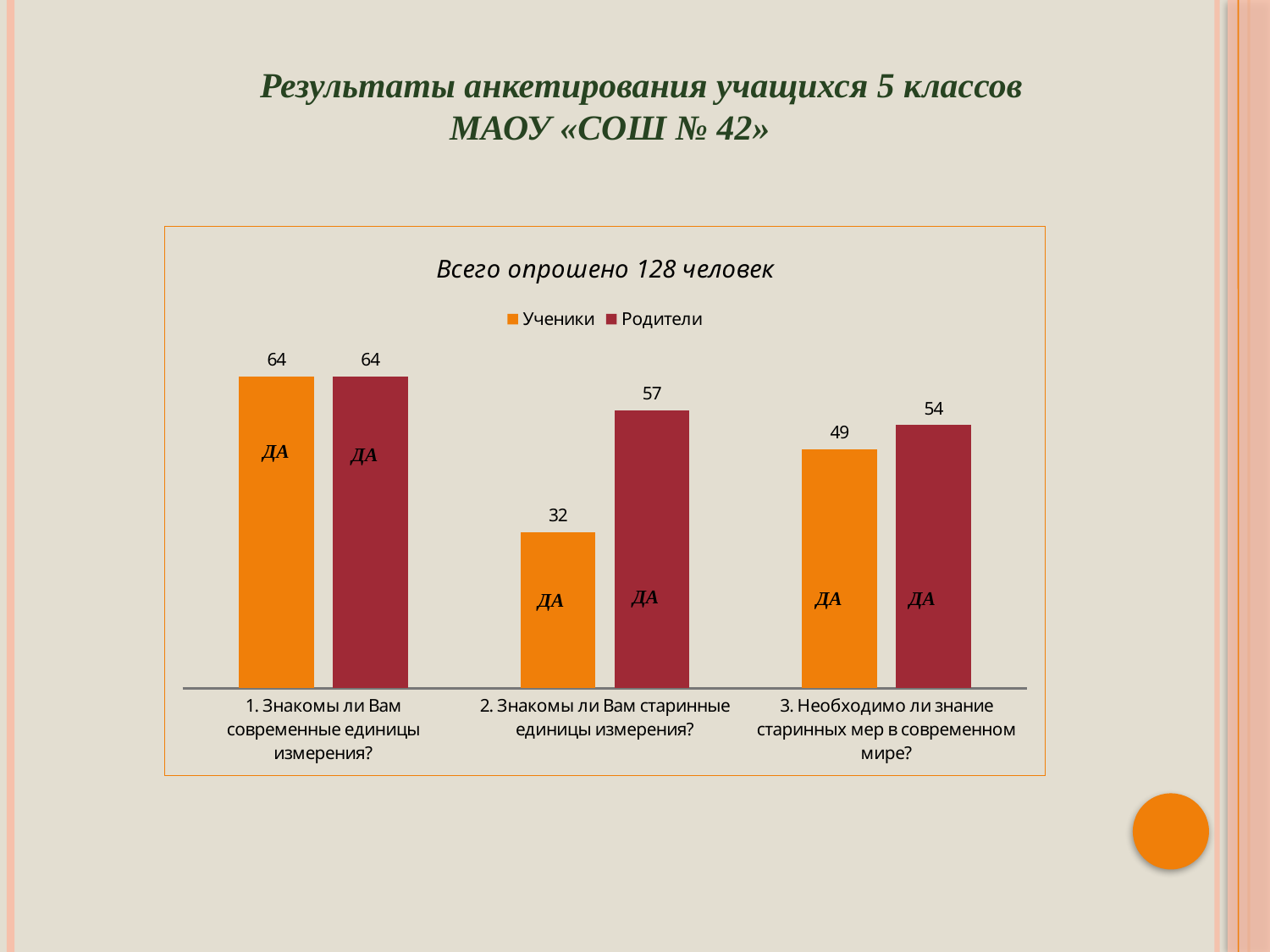
What is the difference between Родители and Ученики on question 3? 5 What is the value for Ученики on question 1 (Знакомы ли Вам современные единицы измерения?)? 64 What is the difference between Родители and Ученики on question 2? 25 How many series does the legend list? 2 Which question has the lowest value for Родители? 3. Необходимо ли знание старинных мер в современном мире? Which question has the lowest value for Ученики? 2. Знакомы ли Вам старинные единицы измерения? What is the value for Родители on question 2 (Знакомы ли Вам старинные единицы измерения?)? 57 What is the value for Ученики on question 2 (Знакомы ли Вам старинные единицы измерения?)? 32 How many questions (categories) are shown on the x axis? 3 On question 3, which is larger: Ученики or Родители? Родители What is the value for Родители on question 3 (Необходимо ли знание старинных мер в современном мире?)? 54 What is the title of the chart? Всего опрошено 128 человек